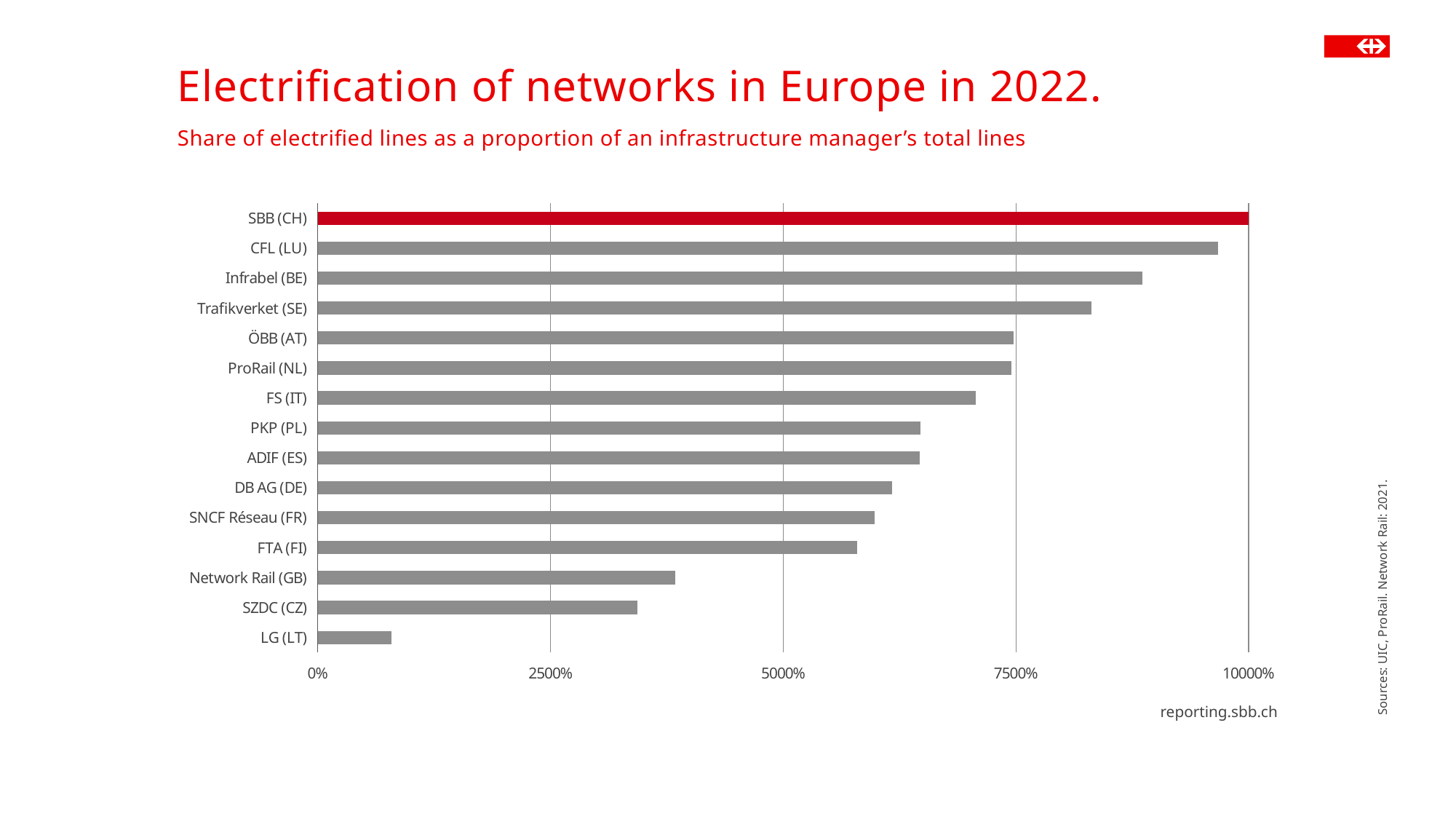
Is the value for CFL (LU) greater or less than 7500%? greater What colour is the bar for SBB (CH)? Red Is the value for Network Rail (GB) greater or less than 5000%? less Is the value for LG (LT) greater or less than 2500%? less How many infrastructure managers are shown in the chart? 15 Which infrastructure manager has the lowest share of electrified lines? LG (LT) Which infrastructure manager has the highest share of electrified lines? SBB (CH) Which is larger, the value for CFL (LU) or the value for Infrabel (BE)? CFL (LU) What kind of chart is shown on the slide? Bar chart